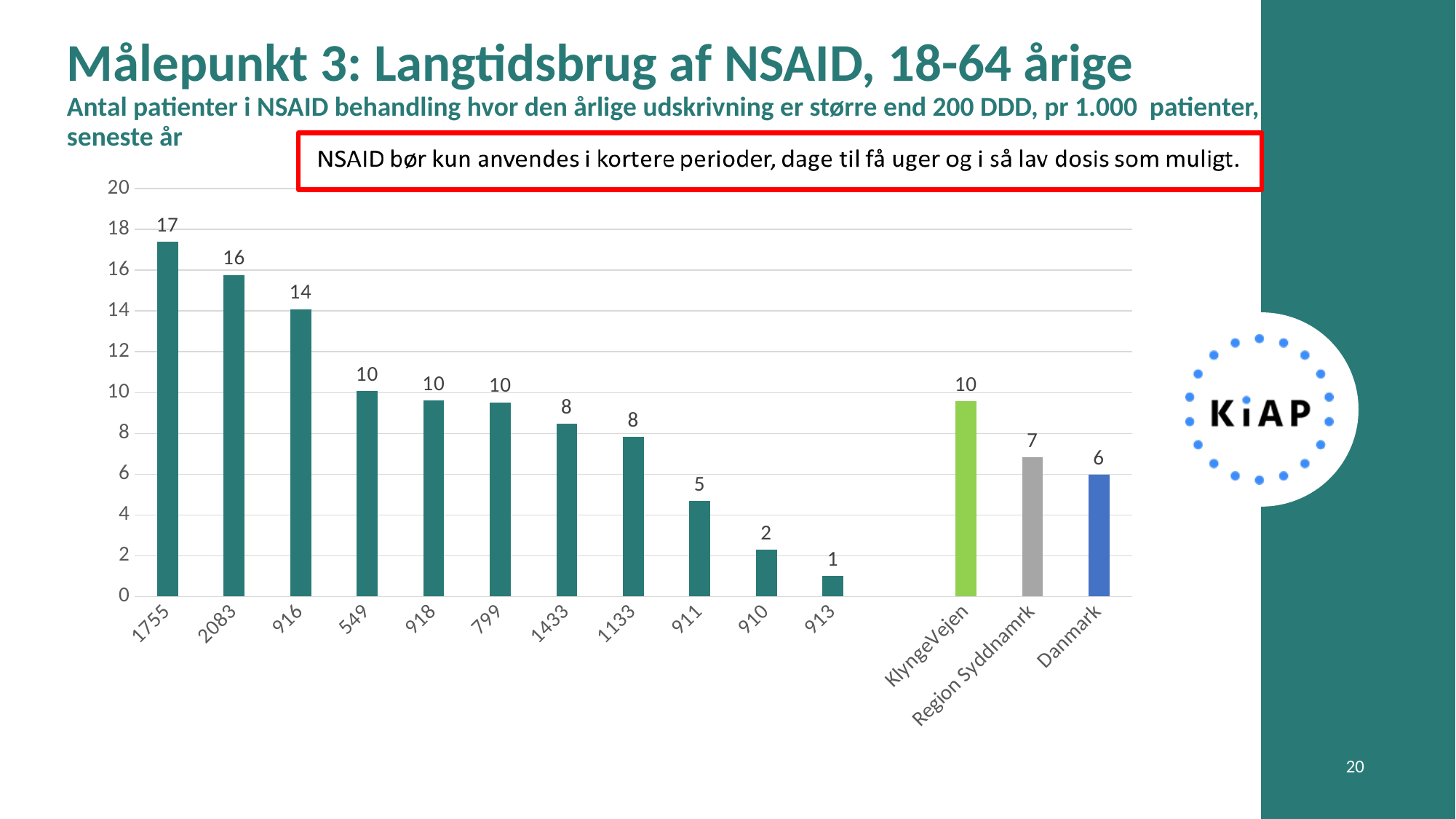
How many categories are shown on the x axis? 14 What is the value for Danmark? 6 Which category has the highest value? 1755 Which is larger, the value for 1133 or the value for 911? 1133 What is the value for KlyngeVejen? 10 What is the difference between the values for KlyngeVejen and Danmark? 4 What is the value for category 1755? 17 What colour is the bar for KlyngeVejen? Green What kind of chart is shown on the slide? Bar chart What is the difference between the values for 2083 and 916? 2 Which category has the lowest value? 913 What is the value for Region Syddnamrk? 7